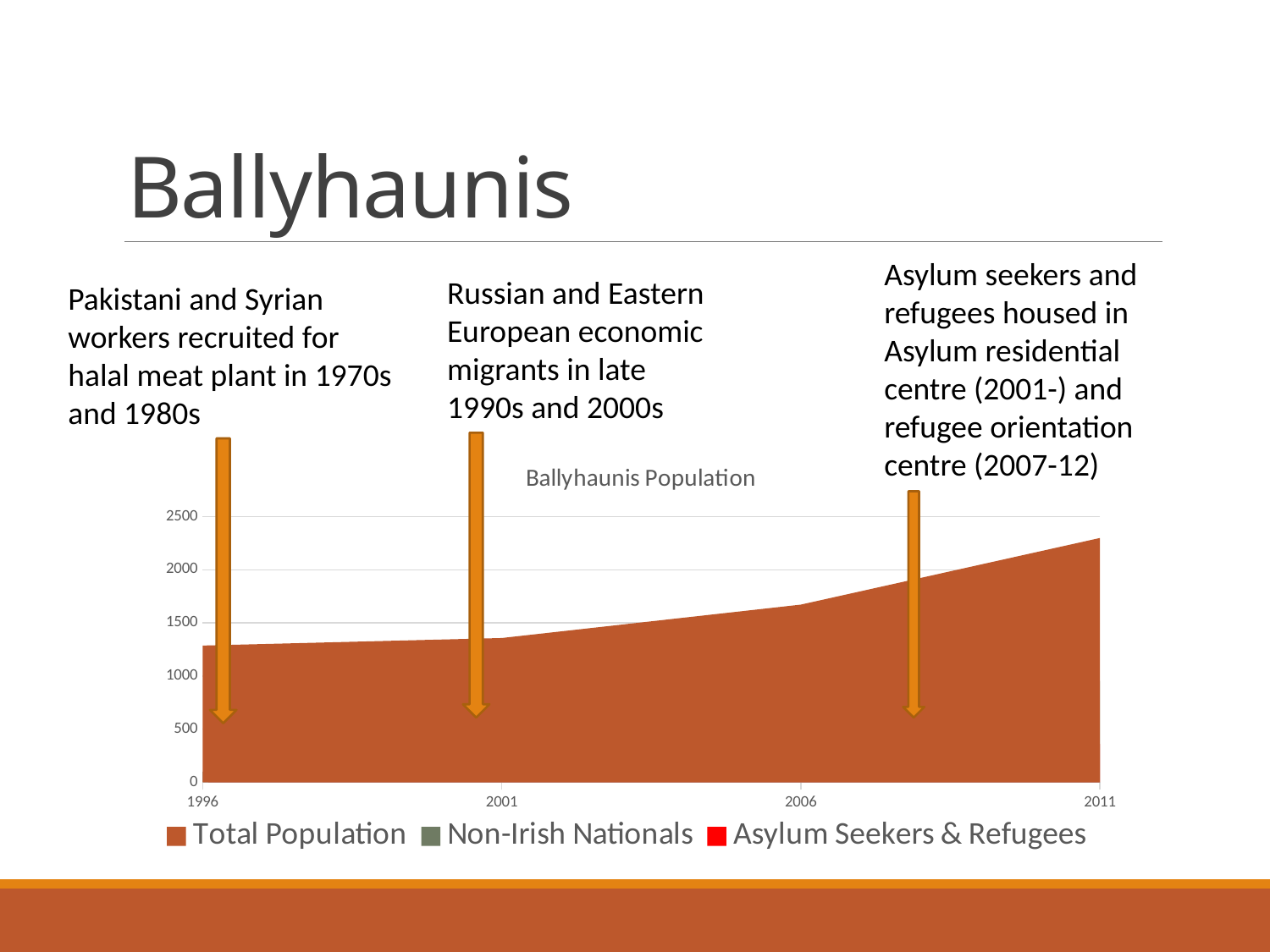
Is the Total Population in 1996 greater or less than 1500? less What kind of chart is shown on the slide? area chart In which year is the Total Population lowest? 1996 Which year has the larger Total Population, 2001 or 2011? 2011 How many series does the chart legend list? 3 Is the Total Population in 2006 greater or less than 1500? greater Does the Total Population rise or fall from 1996 to 2011? rise In which year is the Total Population highest? 2011 Is the Total Population in 2011 greater or less than 2000? greater How many years are labelled on the x axis of the chart? 4 What is the title of the chart? Ballyhaunis Population Which legend entry is shown in red? Asylum Seekers & Refugees